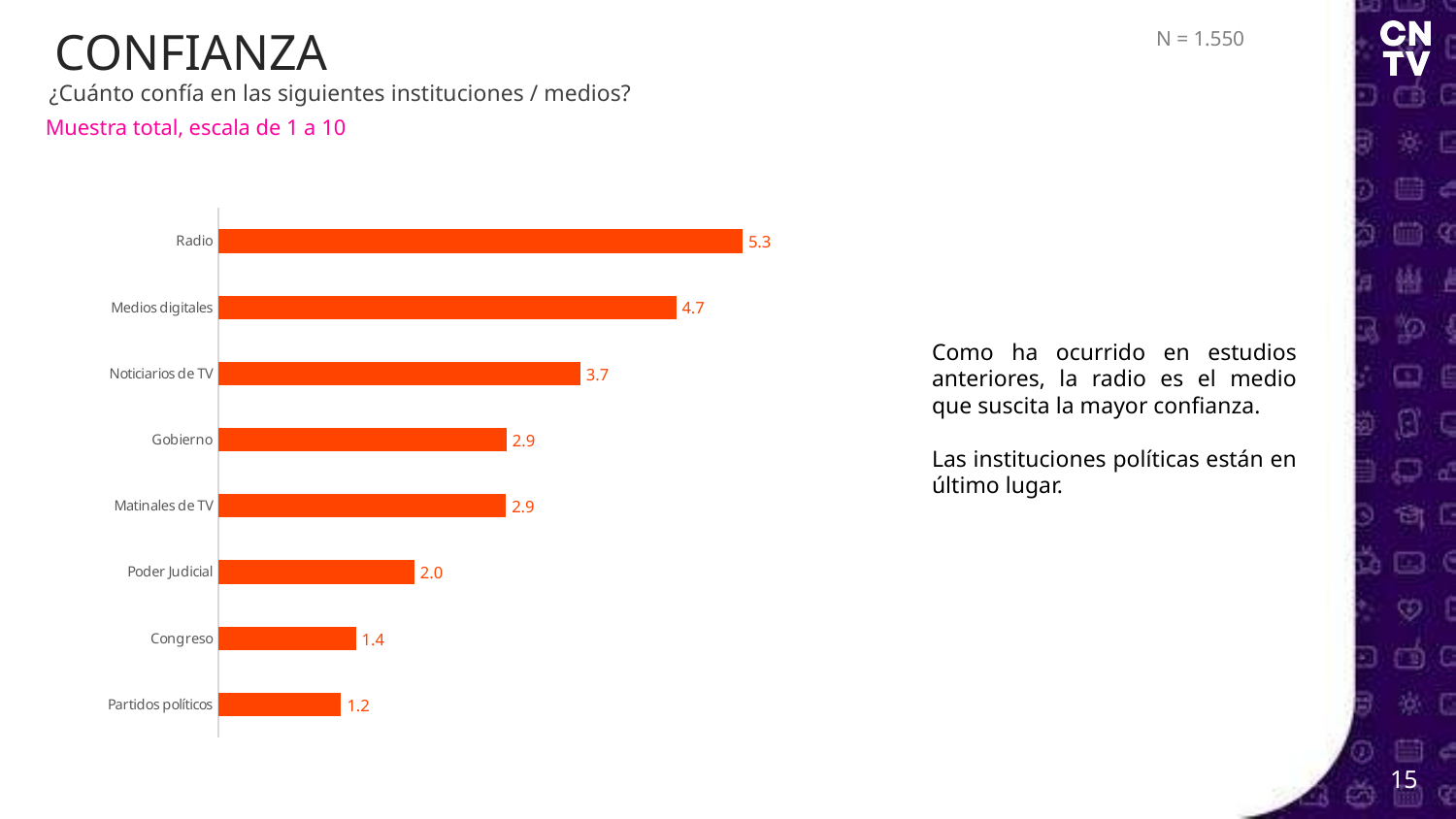
What is the sample size (N) shown on the slide? 1.550 What is the value for Radio? 5.3 Which two categories share the same value of 2.9? Gobierno and Matinales de TV Which category has the lowest value? Partidos políticos Which category has the highest value? Radio Which is larger, the value for Medios digitales or the value for Gobierno? Medios digitales What kind of chart is shown on the slide? Bar chart What is the value for Poder Judicial? 2.0 What is the difference between the values for Radio and Noticiarios de TV? 1.6 How many categories are shown in the chart? 8 What is the value for Medios digitales? 4.7 What is the difference between the values for Congreso and Partidos políticos? 0.2